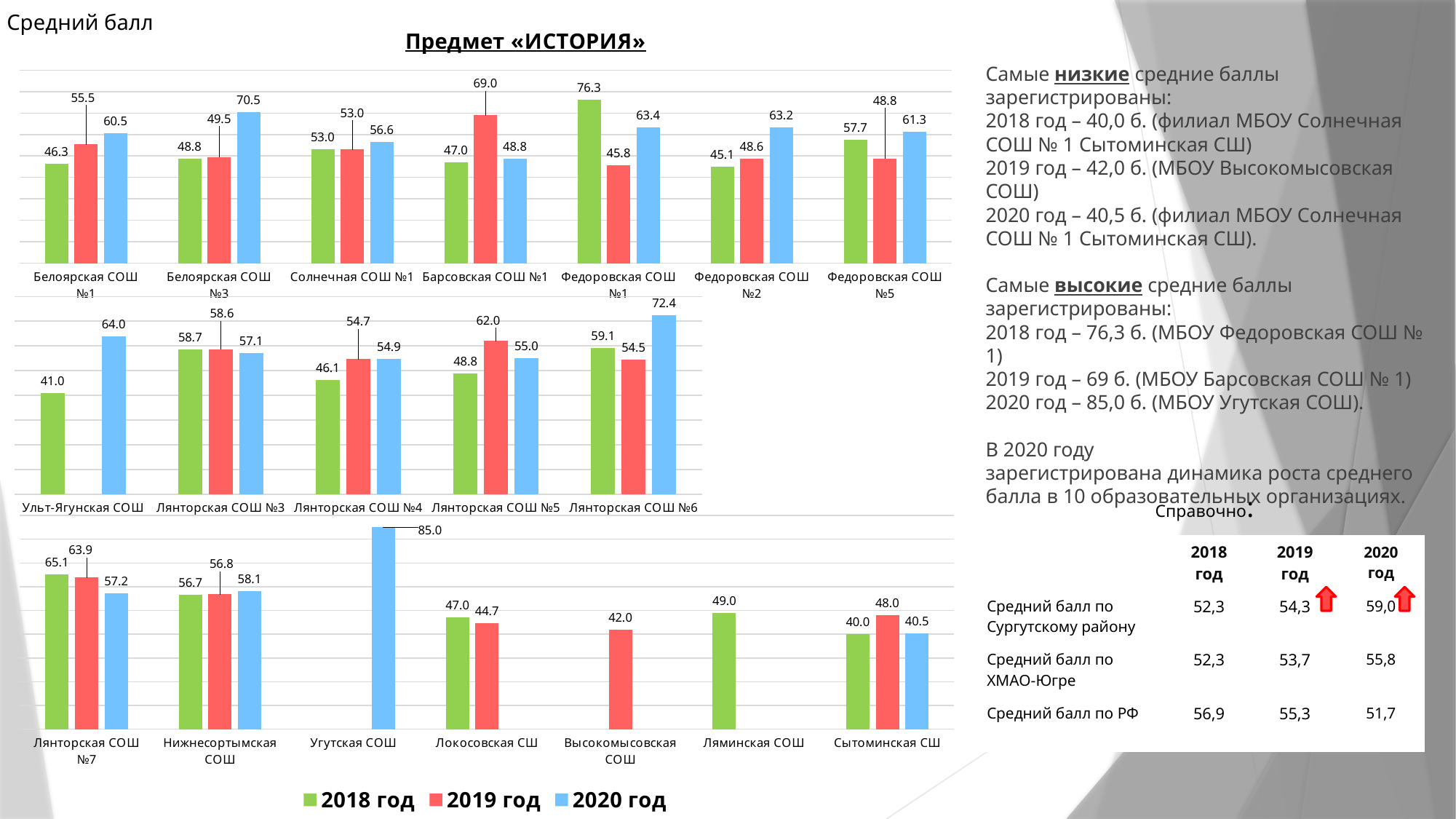
In the bottom chart, how many schools are shown on the x axis? 7 In the middle chart, is the 2019 год value for Лянторская СОШ №5 larger or smaller than the 2019 год value for Лянторская СОШ №4? larger In the bottom chart, which school has the lowest 2018 год value? Сытоминская СШ In the top chart, what is the difference between the 2020 год and 2018 год values for Белоярская СОШ №3? 21.7 In the top chart, what is the 2019 год value for Барсовская СОШ №1? 69.0 What type of chart is used on this slide? bar chart In the bottom chart, what is the 2020 год value for Угутская СОШ? 85.0 In the top chart, which school has the highest 2018 год value? Федоровская СОШ №1 In the middle chart, what is the 2020 год value for Лянторская СОШ №6? 72.4 How many series does the legend list? 3 Which colour represents 2020 год in the legend? blue In the middle chart, which school has the lowest 2018 год value? Ульт-Ягунская СОШ